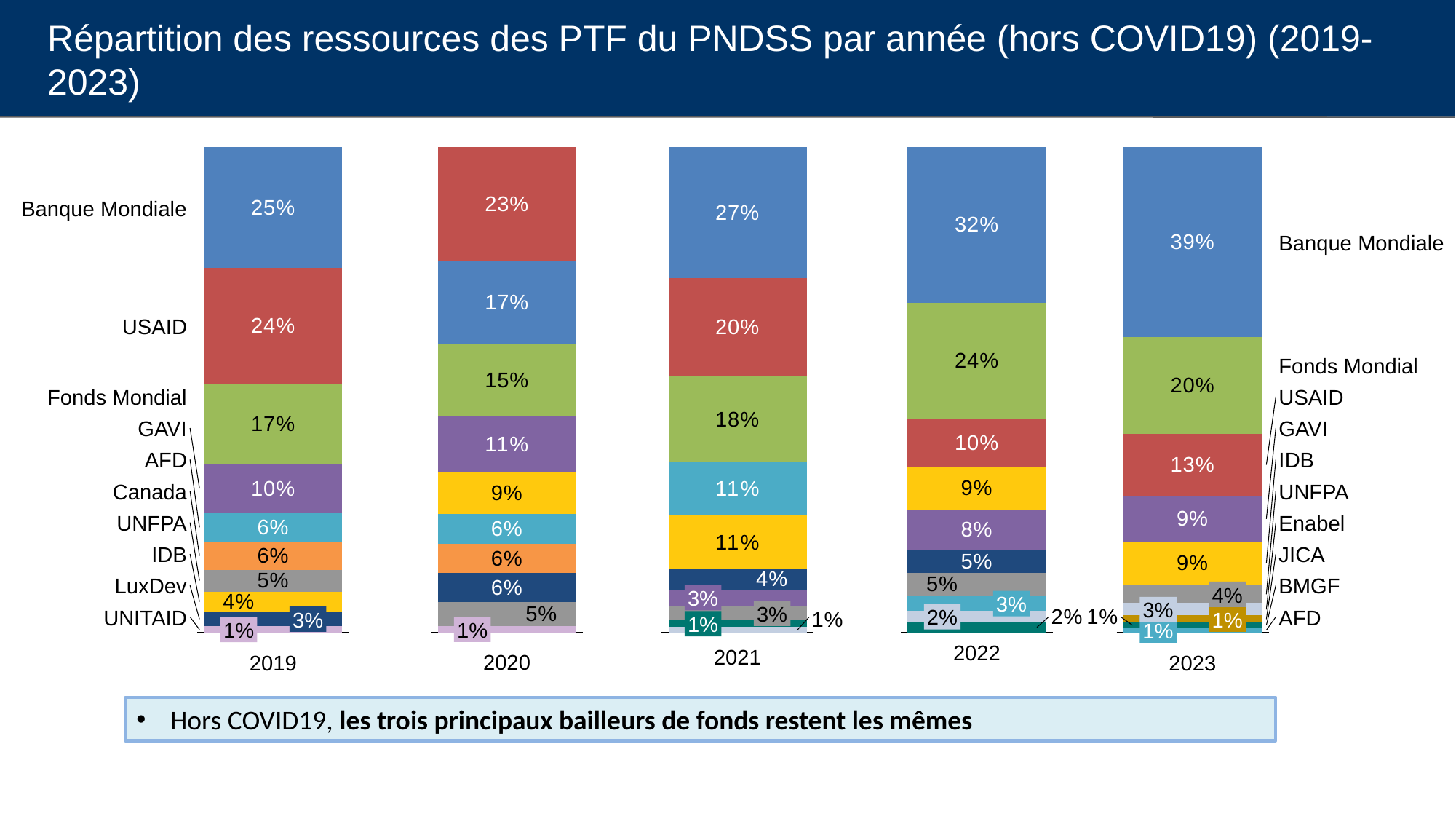
How many years (bars) are shown in the chart? 5 What share of resources did Fonds Mondial represent in 2019? 17% From 2021 to 2023, does the Banque Mondiale share rise or fall? Rise What share of resources did USAID represent in 2023? 13% What is the title of the chart on the slide? Répartition des ressources des PTF du PNDSS par année (hors COVID19) (2019-2023) What share of resources did USAID represent in 2019? 24% In which year is the Banque Mondiale share the highest? 2023 What share of resources did Fonds Mondial represent in 2023? 20% By how many percentage points did the Banque Mondiale share in 2023 exceed its share in 2019? 14 percentage points What kind of chart is shown on the slide? Stacked bar chart What share of resources did Banque Mondiale represent in 2023? 39% What share of resources did Banque Mondiale represent in 2019? 25%